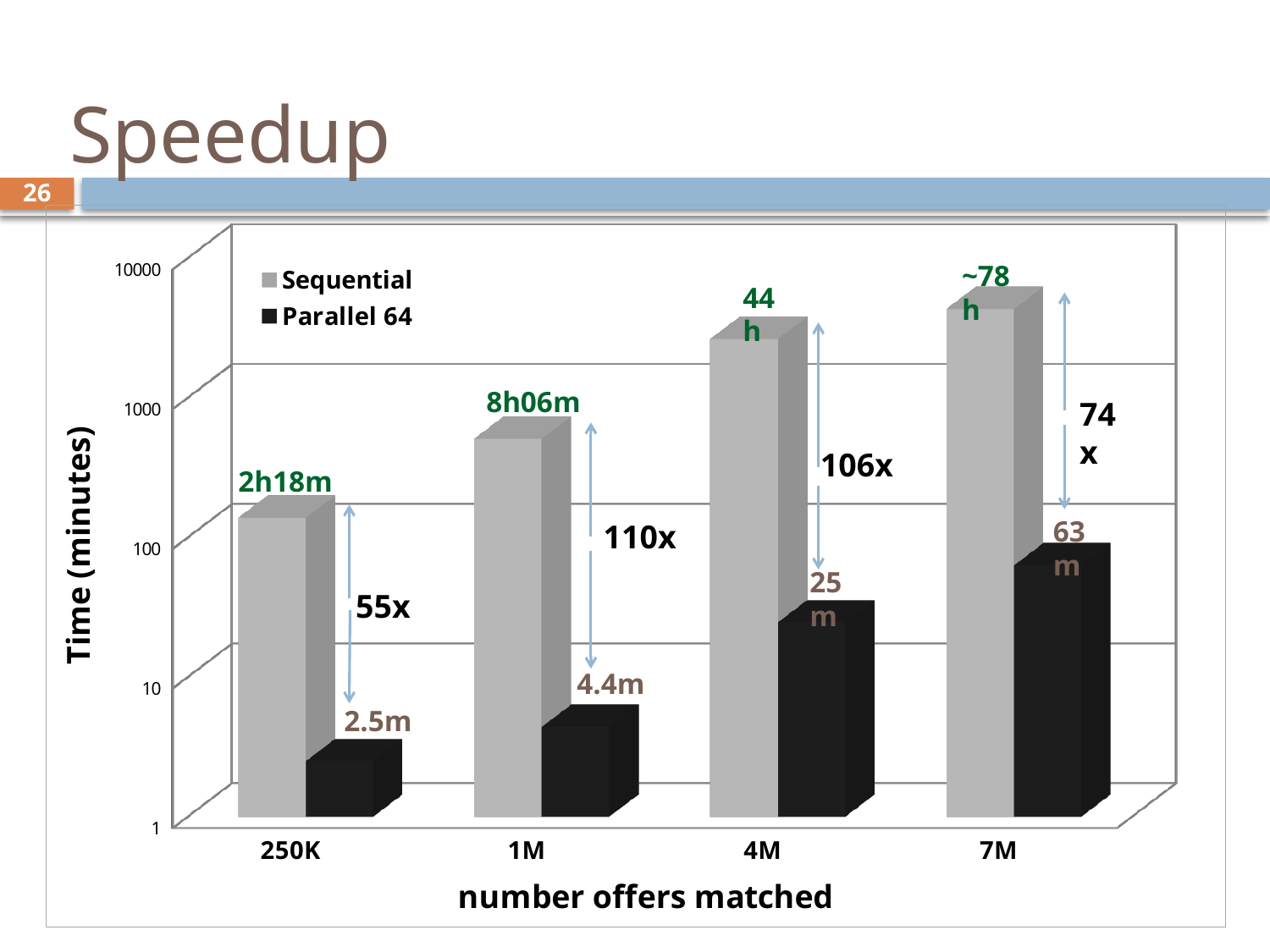
What is the Parallel 64 time for 7M offers matched? 63m Which speedup factor is the smallest shown on the chart? 55x For which number of offers matched is the Sequential time highest? 7M How many series does the legend list? 2 What kind of chart is shown on the slide? bar chart Is the Parallel 64 value for 250K greater or less than 10 minutes? less Is the Sequential value for 7M greater or less than 1000 minutes? greater What speedup factor is shown for 1M offers matched? 110x For which number of offers matched is the Parallel 64 time lowest? 250K What is the Sequential time for 4M offers matched? 44h What is the Parallel 64 time for 1M offers matched? 4.4m What is the Sequential time for 250K offers matched? 2h18m